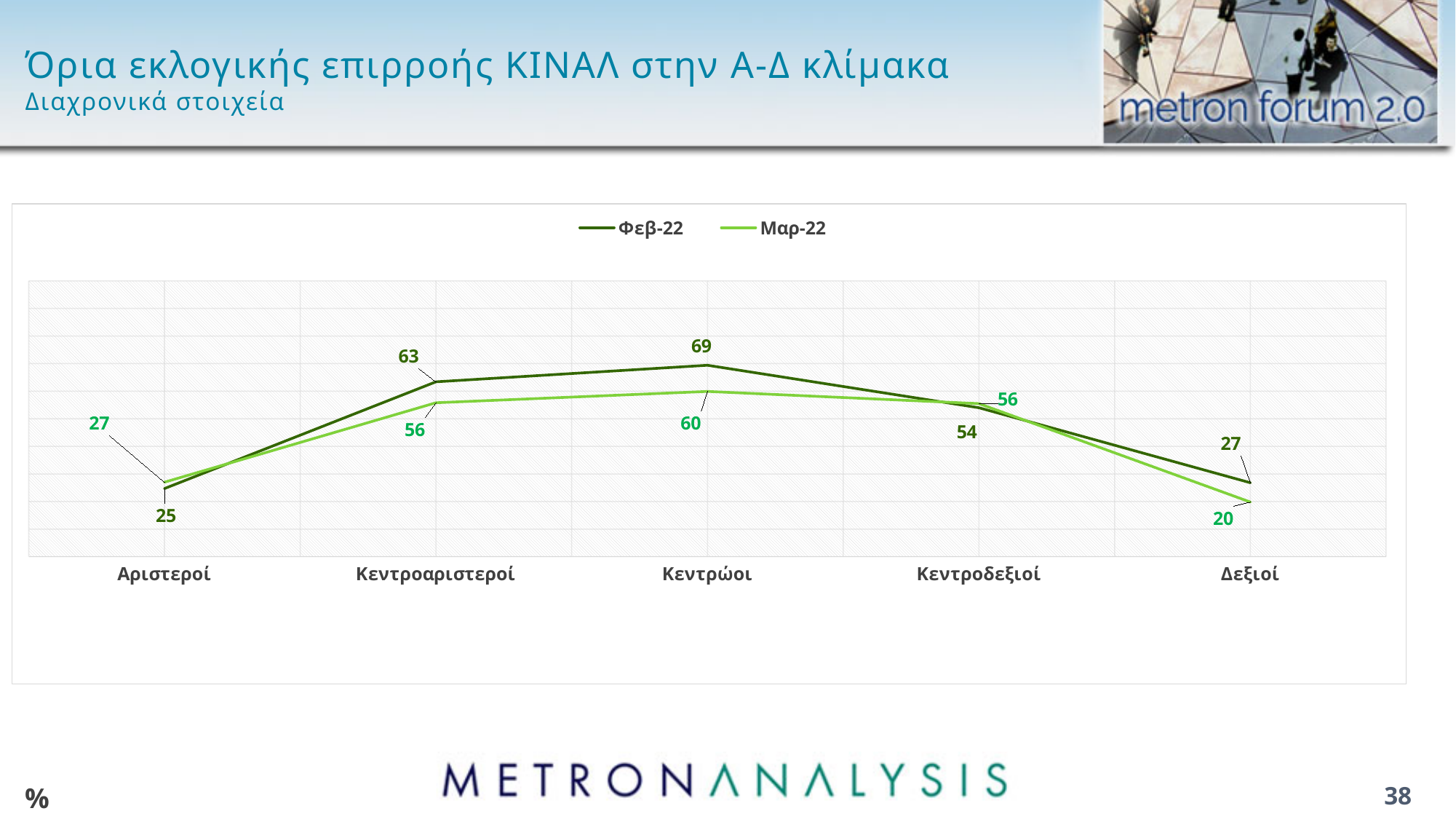
Which category has the highest value in the Φεβ-22 series? Κεντρώοι Which category has the lowest value in the Μαρ-22 series? Δεξιοί For Δεξιοί, which series has the larger value, Φεβ-22 or Μαρ-22? Φεβ-22 What is the difference between the Φεβ-22 values for Κεντροαριστεροί and Αριστεροί? 38 What is the value for Δεξιοί in the Μαρ-22 series? 20 What is the difference between the Φεβ-22 and Μαρ-22 values for Κεντρώοι? 9 What type of chart is shown on the slide? line chart What is the value for Κεντρώοι in the Φεβ-22 series? 69 How many categories are shown on the x axis? 5 What is the value for Κεντροαριστεροί in the Μαρ-22 series? 56 Which series is drawn in the darker green line? Φεβ-22 How many series does the legend list? 2